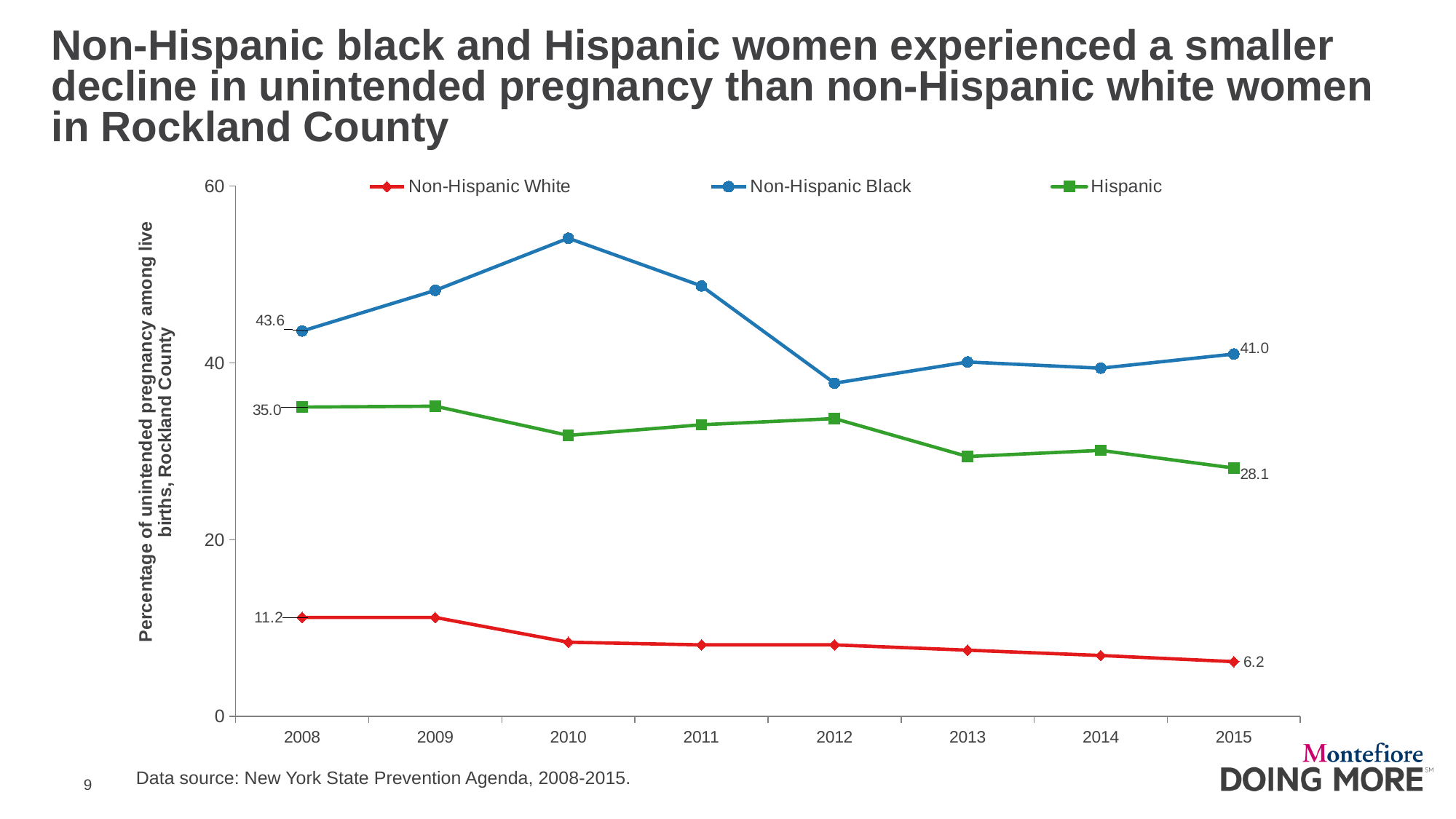
How many years are shown on the x axis? 8 What is the value for Hispanic women in 2015? 28.1 By how much did the value for Non-Hispanic Black women fall from 2008 to 2015? 2.6 What is the value for Non-Hispanic White women in 2008? 11.2 In 2015, which series has the higher value: Non-Hispanic Black or Hispanic? Non-Hispanic Black How many series does the legend list? 3 What is the value for Non-Hispanic Black women in 2008? 43.6 In which year does the Non-Hispanic Black series reach its highest value? 2010 Is the value for Non-Hispanic Black women in 2010 greater or less than 50? greater What is the value for Non-Hispanic White women in 2015? 6.2 What kind of chart is shown on the slide? Line chart By how much did the value for Hispanic women fall from 2008 to 2015? 6.9